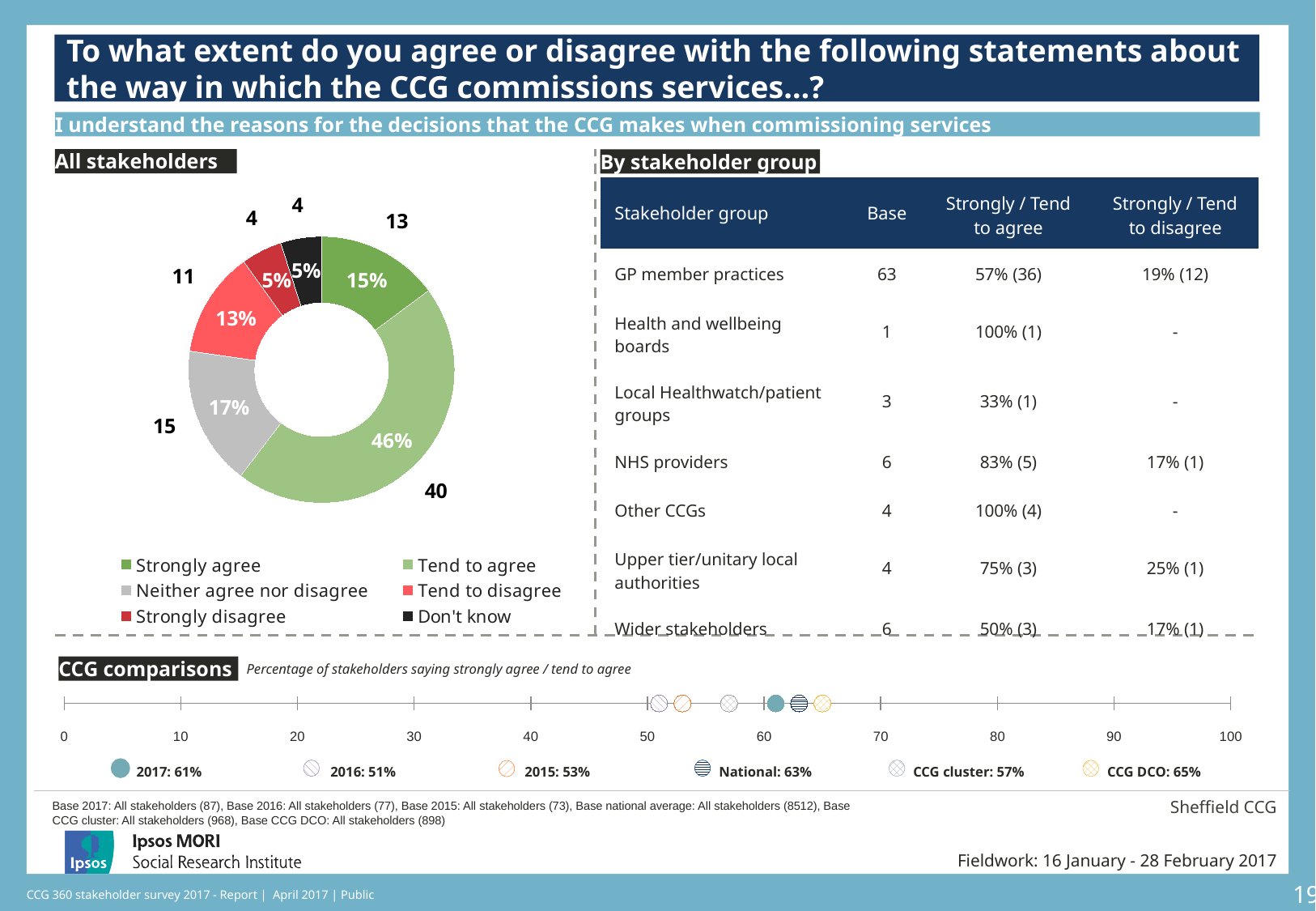
In the CCG comparisons chart, which comparator has the highest value? CCG DCO: 65% In the All stakeholders chart, how many response categories does the legend list? 6 In the CCG comparisons chart, which comparator has the lowest value? 2016: 51% In the All stakeholders chart, which response category has the largest share? Tend to agree In the All stakeholders chart, what percentage said 'Neither agree nor disagree'? 17% In the All stakeholders chart, what is the difference in percentage points between 'Tend to agree' and 'Strongly agree'? 31 percentage points In the All stakeholders chart, what is the combined share of 'Strongly agree' and 'Tend to agree'? 61% In the All stakeholders chart, what percentage of stakeholders said 'Tend to agree'? 46% In the CCG comparisons chart, what is the 2017 value for Sheffield CCG? 61% What kind of chart is the All stakeholders chart? Pie chart (donut) In the All stakeholders chart, how many stakeholders (count) said 'Tend to disagree'? 11 In the All stakeholders chart, which is larger: the share for 'Strongly agree' or for 'Tend to disagree'? Strongly agree